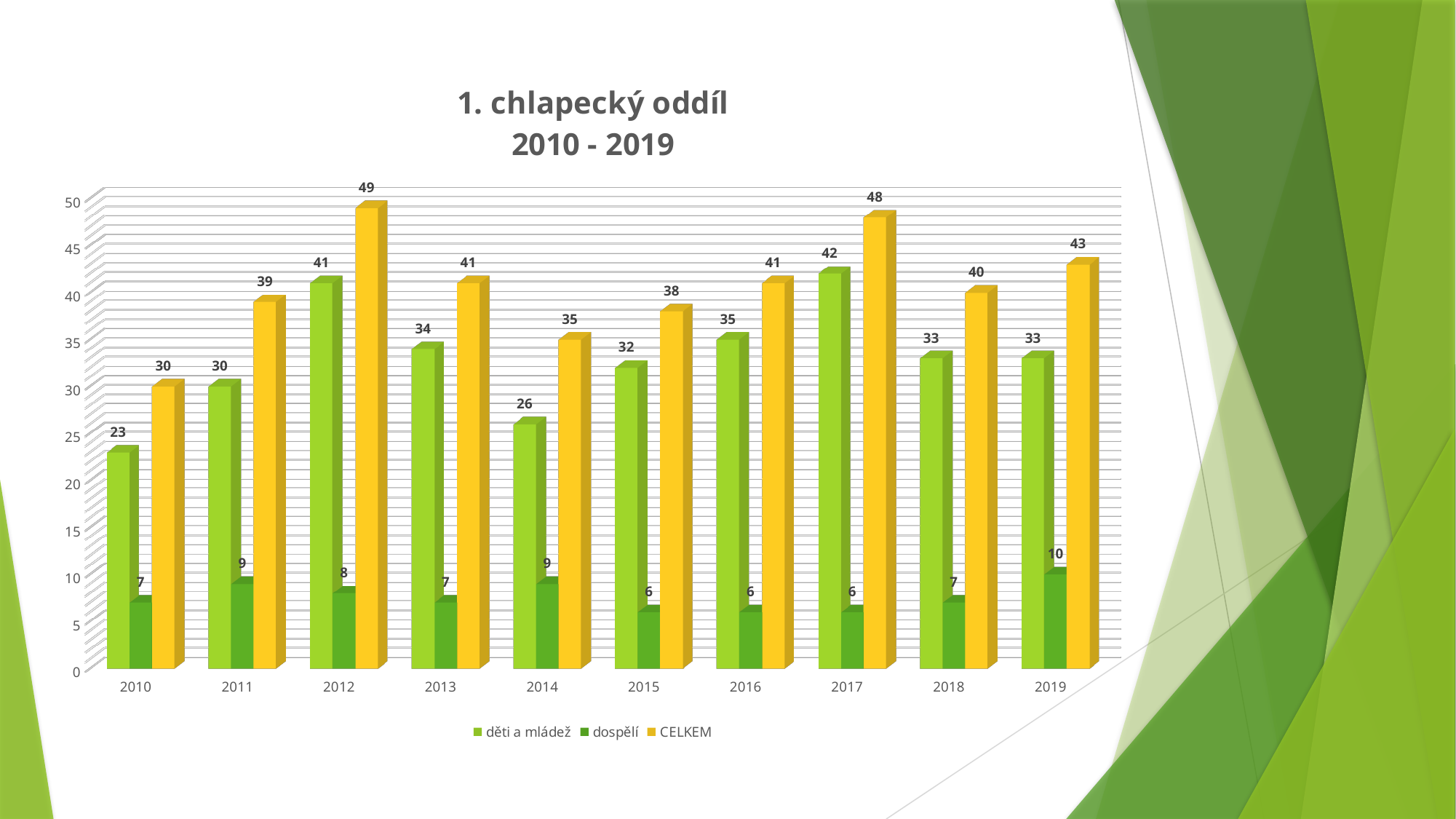
What is the value for 'CELKEM' in 2014? 35 What is the value for 'děti a mládež' in 2012? 41 How many series does the legend list? 3 What kind of chart is shown on the slide? bar chart What is the value for 'dospělí' in 2019? 10 What is the difference between the 'CELKEM' values for 2012 and 2010? 19 What is the title of the chart? 1. chlapecký oddíl 2010 - 2019 Which is larger: the 'děti a mládež' value in 2013 or in 2016? 2016 In which year is the 'CELKEM' value highest? 2012 In which year is the 'děti a mládež' value lowest? 2010 How many years are shown on the x axis? 10 Does the 'CELKEM' value rise or fall from 2017 to 2018? fall